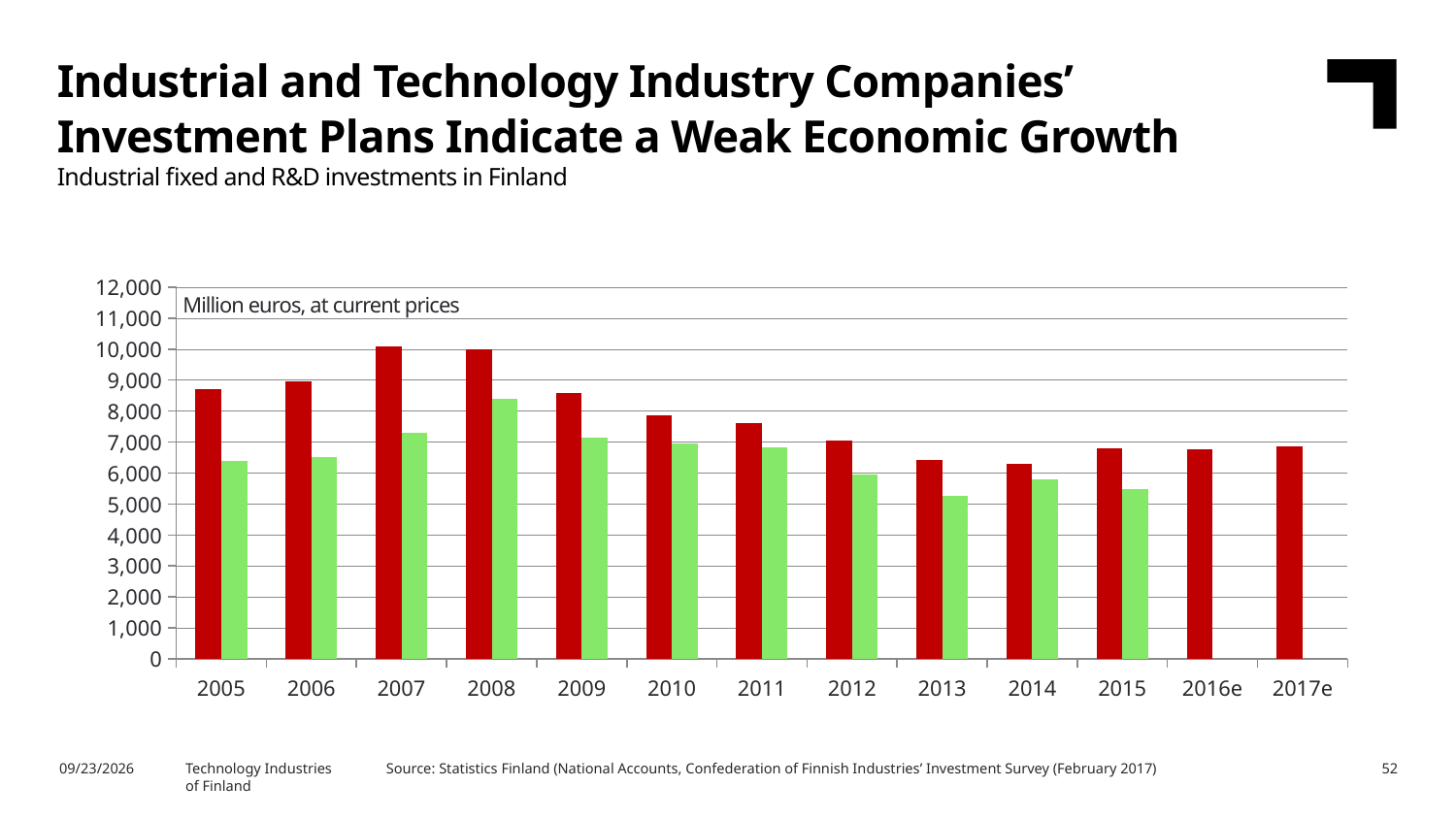
What is the subtitle of the chart below the slide title? Industrial fixed and R&D investments in Finland In which year is the green bar lowest? 2013 Which is larger, the red bar for 2007 or the red bar for 2013? 2007 In which year is the green bar highest? 2008 What kind of chart is shown on the slide? bar chart Is the green bar for 2008 greater or less than 8,000? greater Is the red bar for 2005 greater or less than 8,000? greater What does the label inside the plot area say the values are measured in? Million euros, at current prices Is the green bar for 2013 greater or less than 6,000? less Do the red bars rise or fall from 2008 to 2014? fall How many years (categories) are shown on the x axis? 13